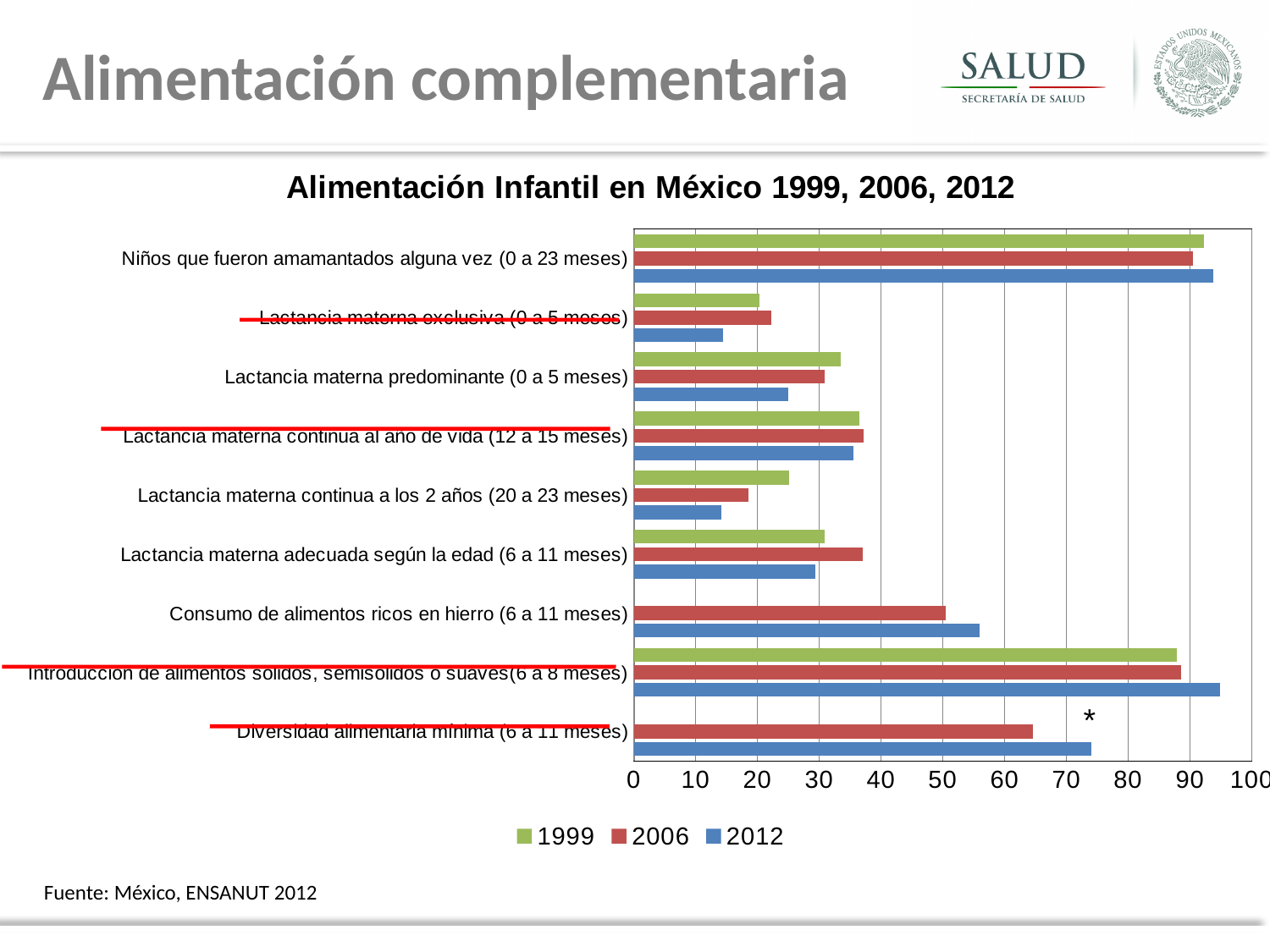
Is the 2012 value for Lactancia materna exclusiva (0 a 5 meses) greater or less than 20? less For Diversidad alimentaria mínima (6 a 11 meses), which year has the larger value, 2006 or 2012? 2012 Is the 2012 value for Introducción de alimentos sólidos, semisólidos o suaves (6 a 8 meses) greater or less than 90? greater Is the 2012 value for Lactancia materna continua a los 2 años (20 a 23 meses) greater or less than 20? less What kind of chart is shown on the slide? Bar chart For Lactancia materna continua a los 2 años (20 a 23 meses), which year has the highest value? 1999 How many categories are shown on the vertical axis of the chart? 9 How many series does the legend list? 3 Which series has no bar for Consumo de alimentos ricos en hierro (6 a 11 meses)? 1999 For Lactancia materna exclusiva (0 a 5 meses), which year has the larger value, 1999 or 2012? 1999